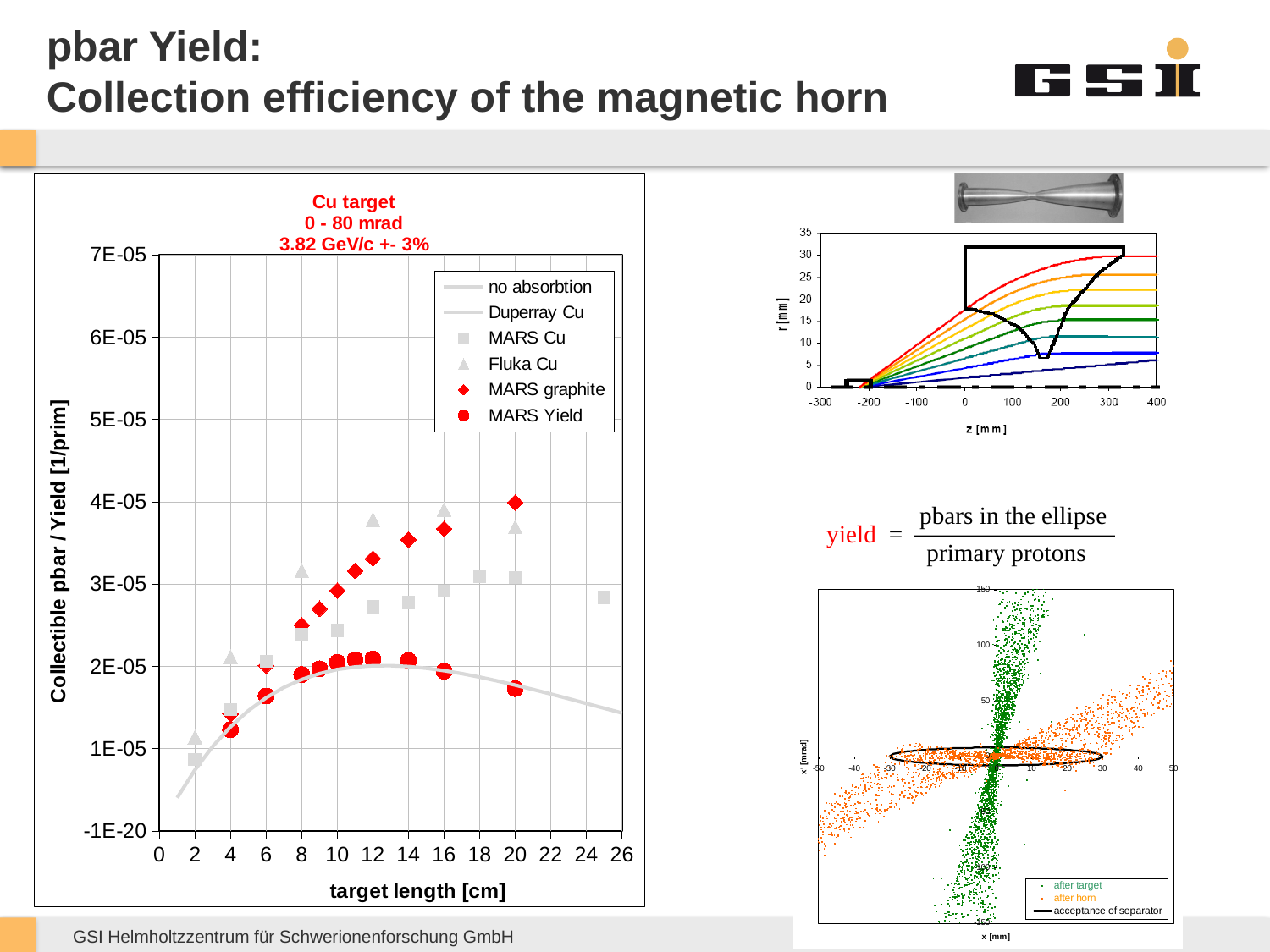
On the left chart, is the MARS Yield value at a target length of 12 cm greater or less than 3E-05? less On the left chart, is the Fluka Cu value at a target length of 16 cm greater or less than 3E-05? greater On the left chart (Cu target), how many series does the legend list? 6 On the left chart, do the MARS graphite values rise or fall as the target length increases from 8 cm to 20 cm? rise What kind of chart is the left chart showing collectible pbar versus target length? scatter chart On the left chart, at a target length of 20 cm, which is larger: MARS graphite or MARS Yield? MARS graphite On the left chart, is the MARS Yield value at a target length of 4 cm greater or less than 2E-05? less On the left chart, what is the x-axis title? target length [cm] On the left chart, at a target length of 16 cm, which is larger: MARS graphite or MARS Cu? MARS graphite On the bottom-right scatter chart (x' [mrad] versus x [mm]), how many entries does the legend list? 3